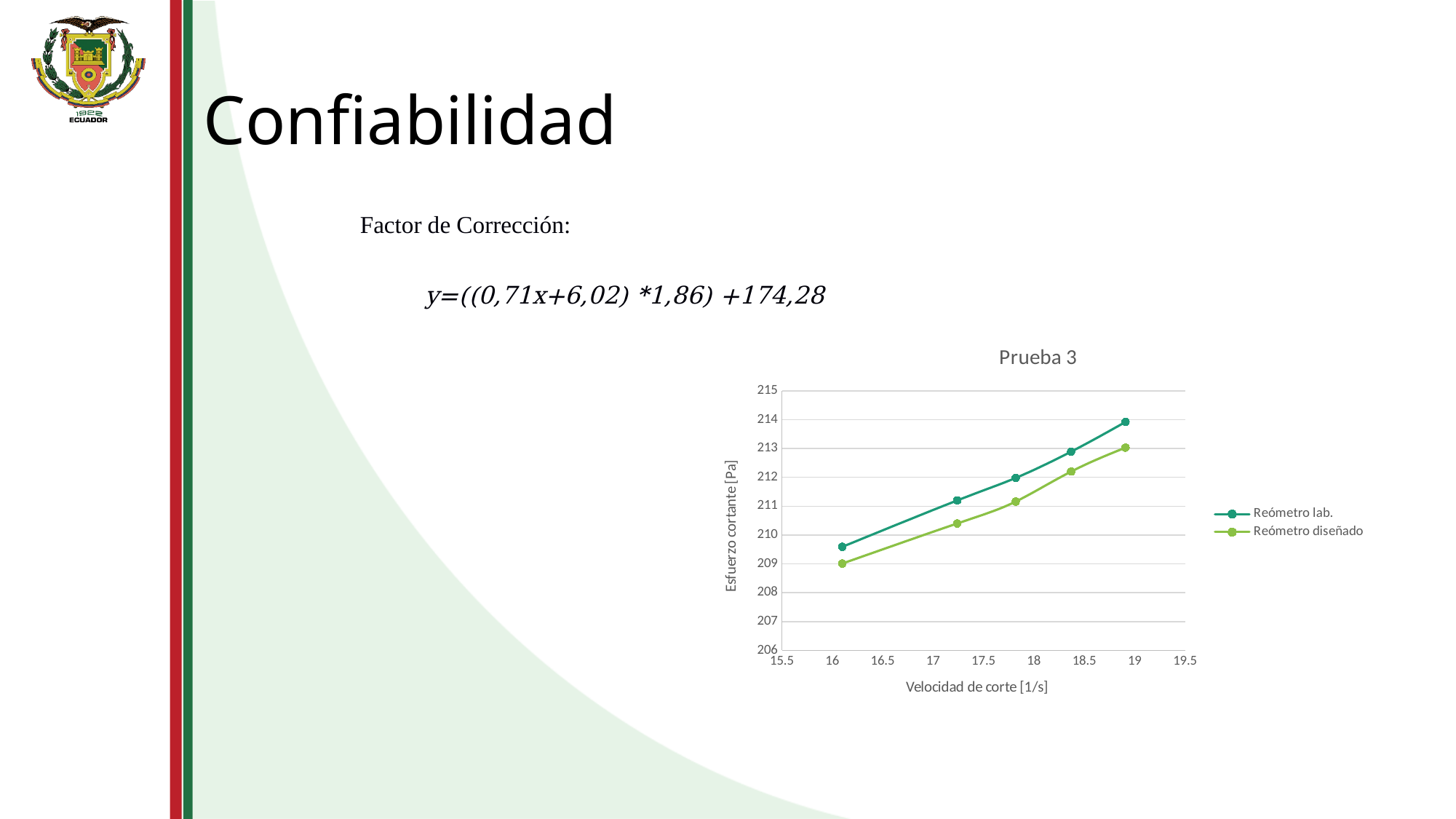
Which series has the higher esfuerzo cortante at the highest velocidad de corte, Reómetro lab. or Reómetro diseñado? Reómetro lab. What is the title of the chart? Prueba 3 Which series lies above the other across the whole chart? Reómetro lab. What kind of chart is shown on the slide? line chart How many data points does the Reómetro lab. series have? 5 Is the value of the Reómetro diseñado series at its highest velocidad de corte greater or less than 214? less Is the value of the Reómetro lab. series at its highest velocidad de corte greater or less than 213? greater Is the value of the Reómetro diseñado series at its lowest velocidad de corte greater or less than 210? less Do the values of the Reómetro lab. series rise or fall as the velocidad de corte increases? rise What is the label of the x axis of the chart? Velocidad de corte [1/s] How many series does the legend of the chart list? 2